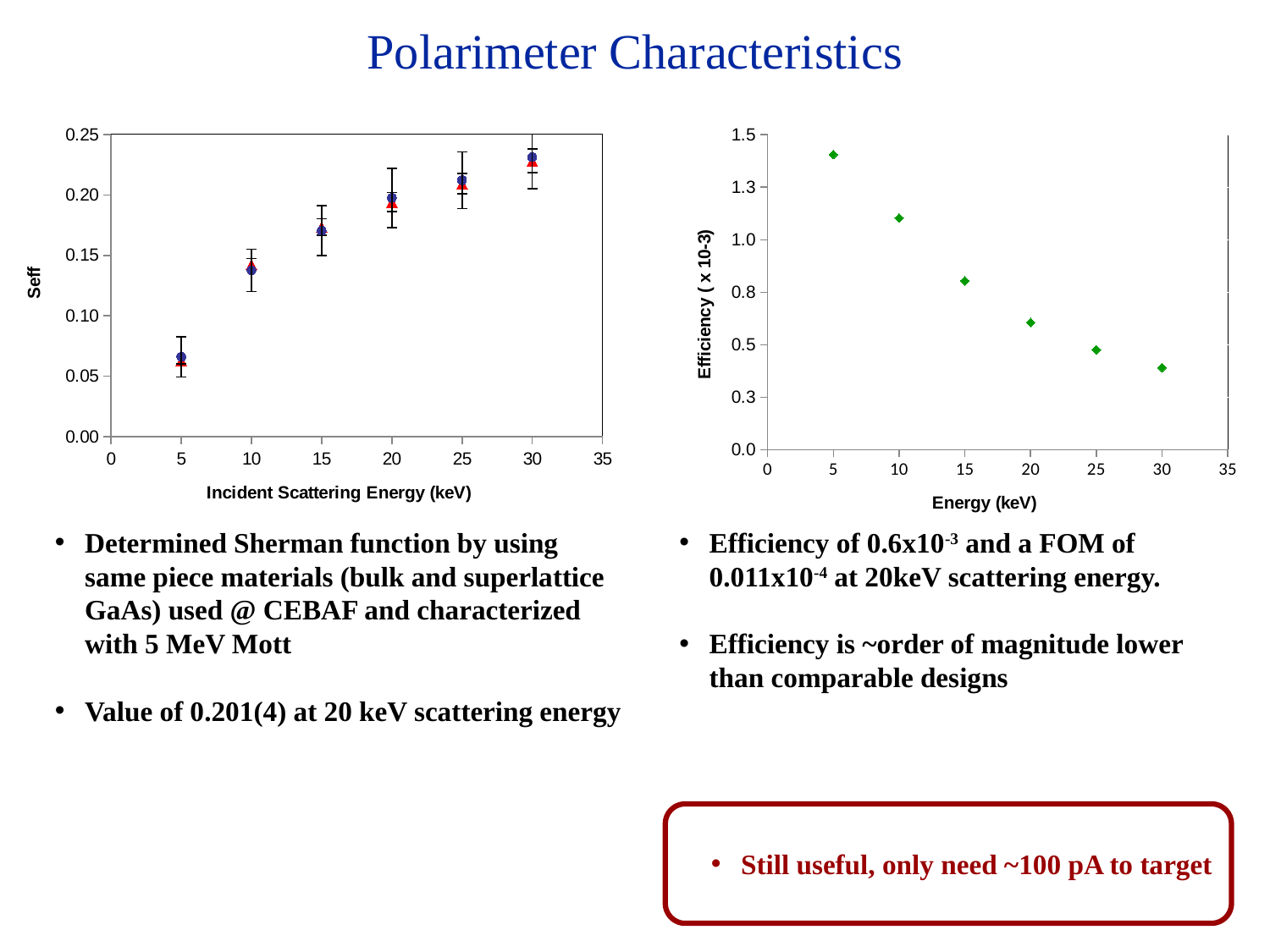
In the left chart (Seff), is the value at 30 keV greater or less than 0.20? greater In the right chart (Efficiency), at which energy is the efficiency lowest? 30 keV What kind of chart is the right chart (Efficiency vs Energy)? scatter chart In the left chart (Seff), is the value at 5 keV greater or less than 0.10? less In the left chart (Seff), at which incident scattering energy is Seff lowest? 5 keV In the right chart (Efficiency), do the values rise or fall as the energy increases? fall In the right chart (Efficiency), how many data points are plotted? 6 In the right chart (Efficiency), is the value at 30 keV greater or less than 0.5? less In the right chart (Efficiency), at which energy is the efficiency highest? 5 keV What is the x-axis title of the right chart? Energy (keV) What kind of chart is the left chart (Seff vs Incident Scattering Energy)? scatter chart In the left chart (Seff), do the values rise or fall as the incident scattering energy increases? rise